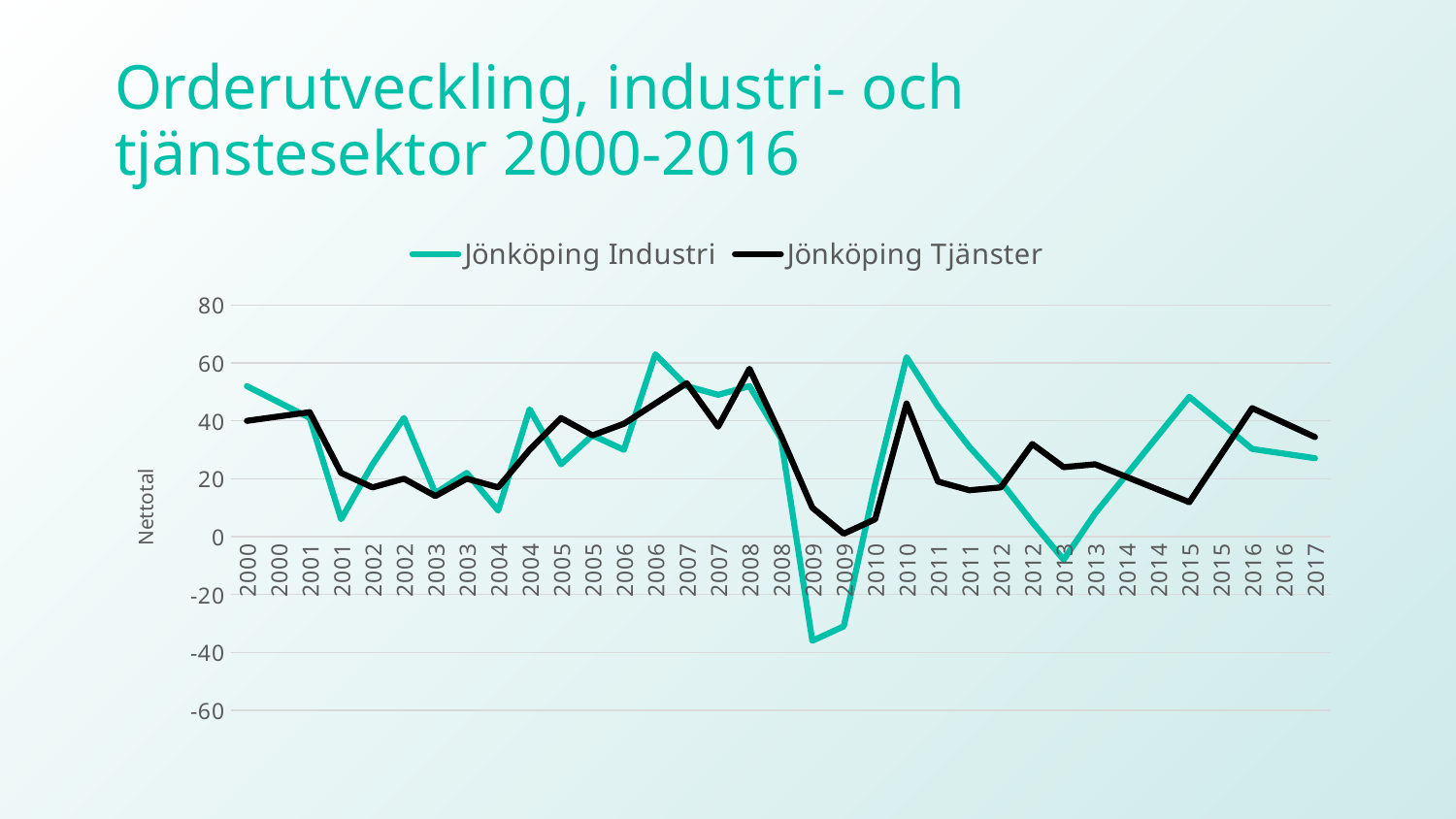
Is the value for Jönköping Industri at the first 2013 point greater or less than 0? less Is the value for Jönköping Tjänster at the second 2015 point greater or less than 20? greater Is the value for Jönköping Industri at the first 2000 point greater or less than 40? greater What are the names of the two series in the legend? Jönköping Industri and Jönköping Tjänster At which x-axis point does Jönköping Industri reach its lowest value? the first 2009 point At the first 2009 point, which series has the higher value, Jönköping Industri or Jönköping Tjänster? Jönköping Tjänster How many points are plotted along the x axis for each series? 35 What kind of chart is shown on the slide? line chart What is the label on the vertical axis? Nettotal How many series does the legend list? 2